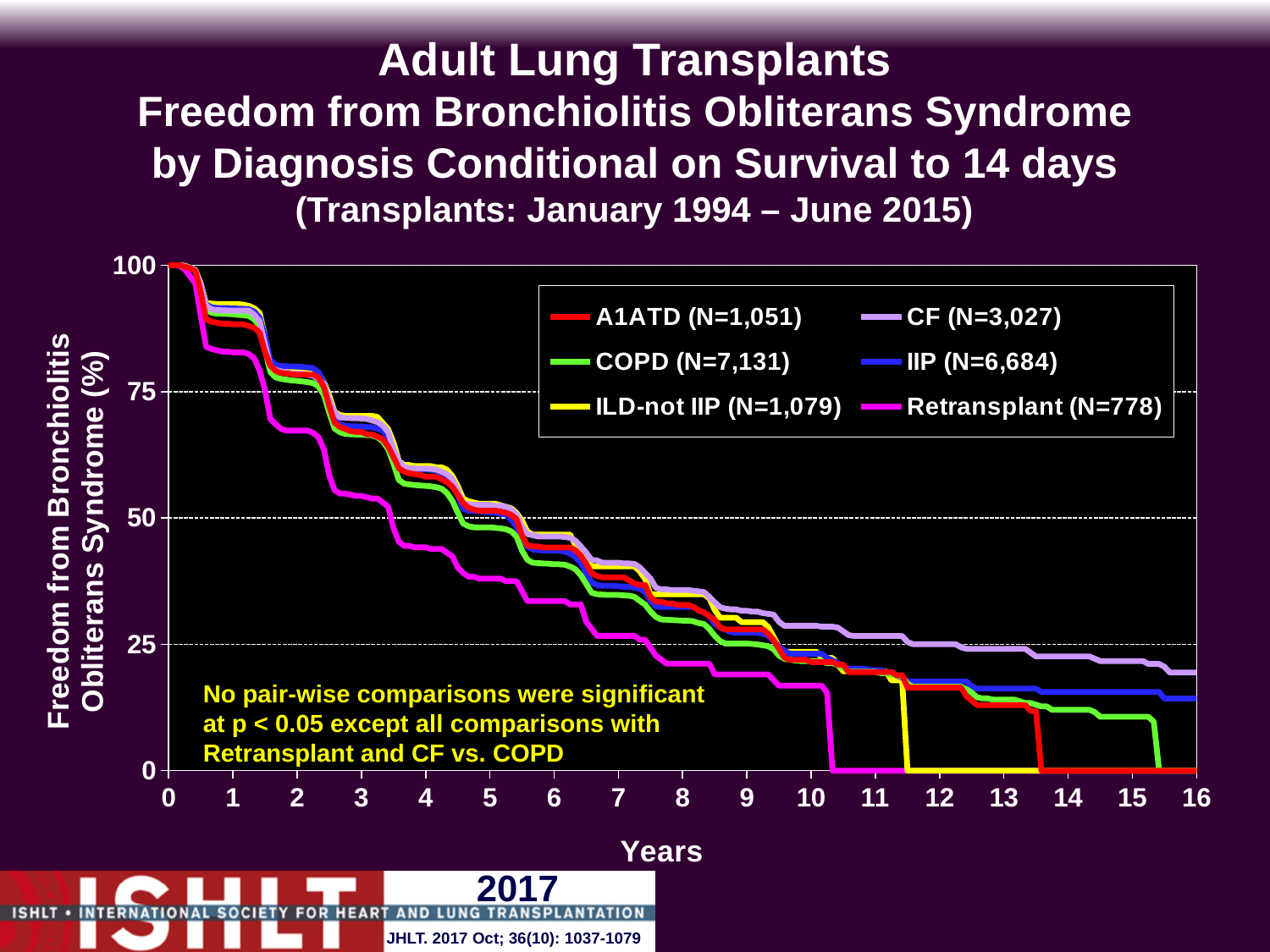
What is the label of the x axis? Years According to the legend, what is the N for the COPD group? 7,131 At 14 years, which curve is higher, CF or COPD? CF What is the difference between the N for COPD and the N for IIP shown in the legend? 447 Do the freedom from BOS curves rise or fall as years increase? fall Which diagnosis group has the largest N in the legend? COPD Which diagnosis group has the smallest N in the legend? Retransplant What type of chart is shown on the slide? line chart How many series does the legend list? 6 At 9 years, is the value for CF greater or less than 25? greater According to the legend, what is the N for the Retransplant group? 778 At 6 years, is the value for Retransplant greater or less than 50? less